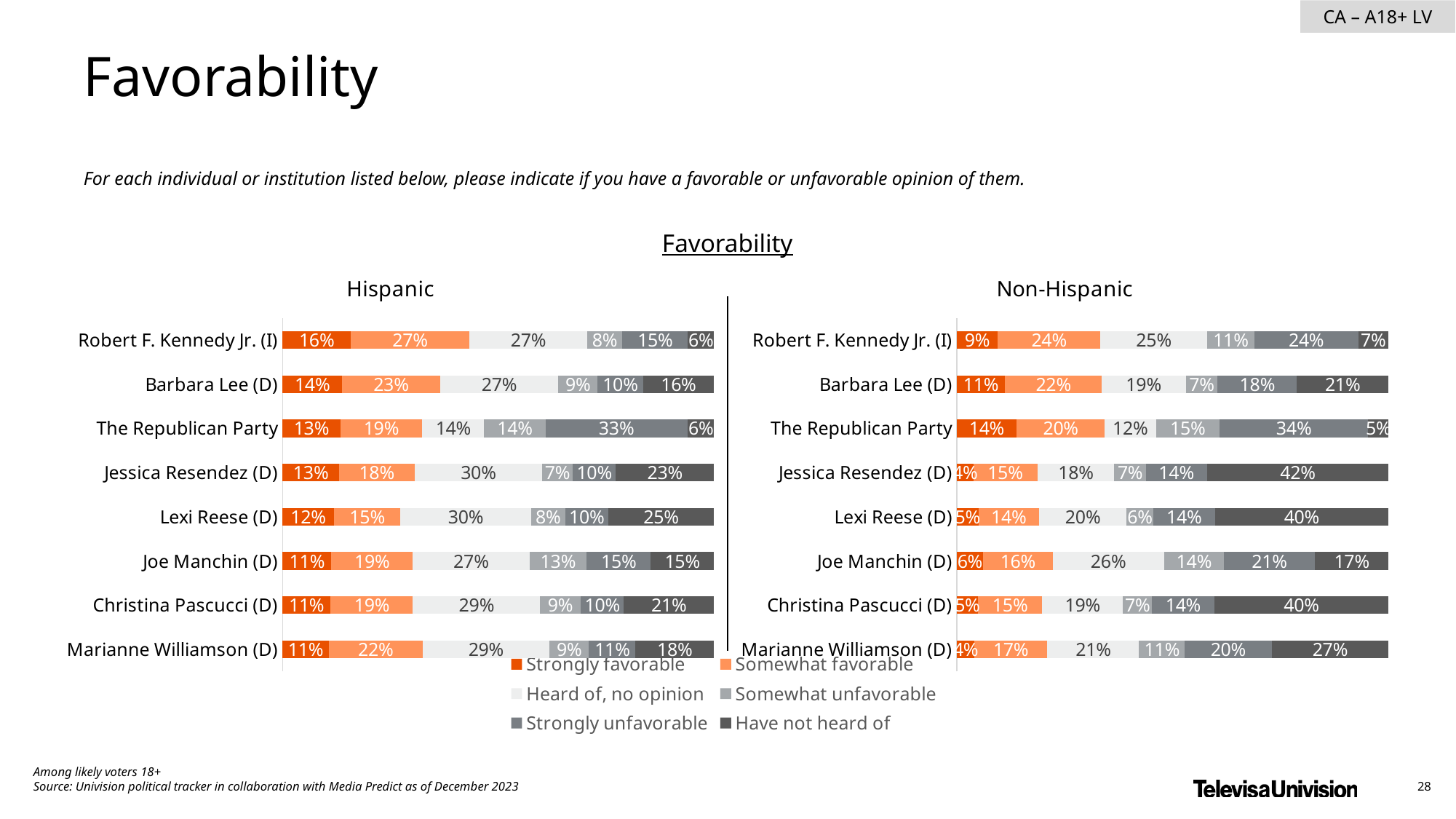
How many series does the legend list? 6 In the Non-Hispanic chart, what is the combined Strongly favorable and Somewhat favorable value for Robert F. Kennedy Jr. (I)? 33% In the Non-Hispanic chart, what is the Have not heard of value for Jessica Resendez (D)? 42% In the Hispanic chart, which individual or institution has the highest Strongly unfavorable value? The Republican Party In the Non-Hispanic chart, is the Strongly favorable value larger for Barbara Lee (D) or for Joe Manchin (D)? Barbara Lee (D) How many individuals or institutions are listed in the Hispanic chart? 8 In the Hispanic chart, what is the Strongly favorable value for Robert F. Kennedy Jr. (I)? 16% In the Hispanic chart, what is the Heard of, no opinion value for The Republican Party? 14% In the Hispanic chart, what is the difference between the Somewhat favorable values for Robert F. Kennedy Jr. (I) and Lexi Reese (D)? 12% What type of chart is used for the Non-Hispanic data? Stacked bar chart In the Non-Hispanic chart, which individual or institution has the lowest Have not heard of value? The Republican Party Which legend entry is shown in the darkest orange colour? Strongly favorable